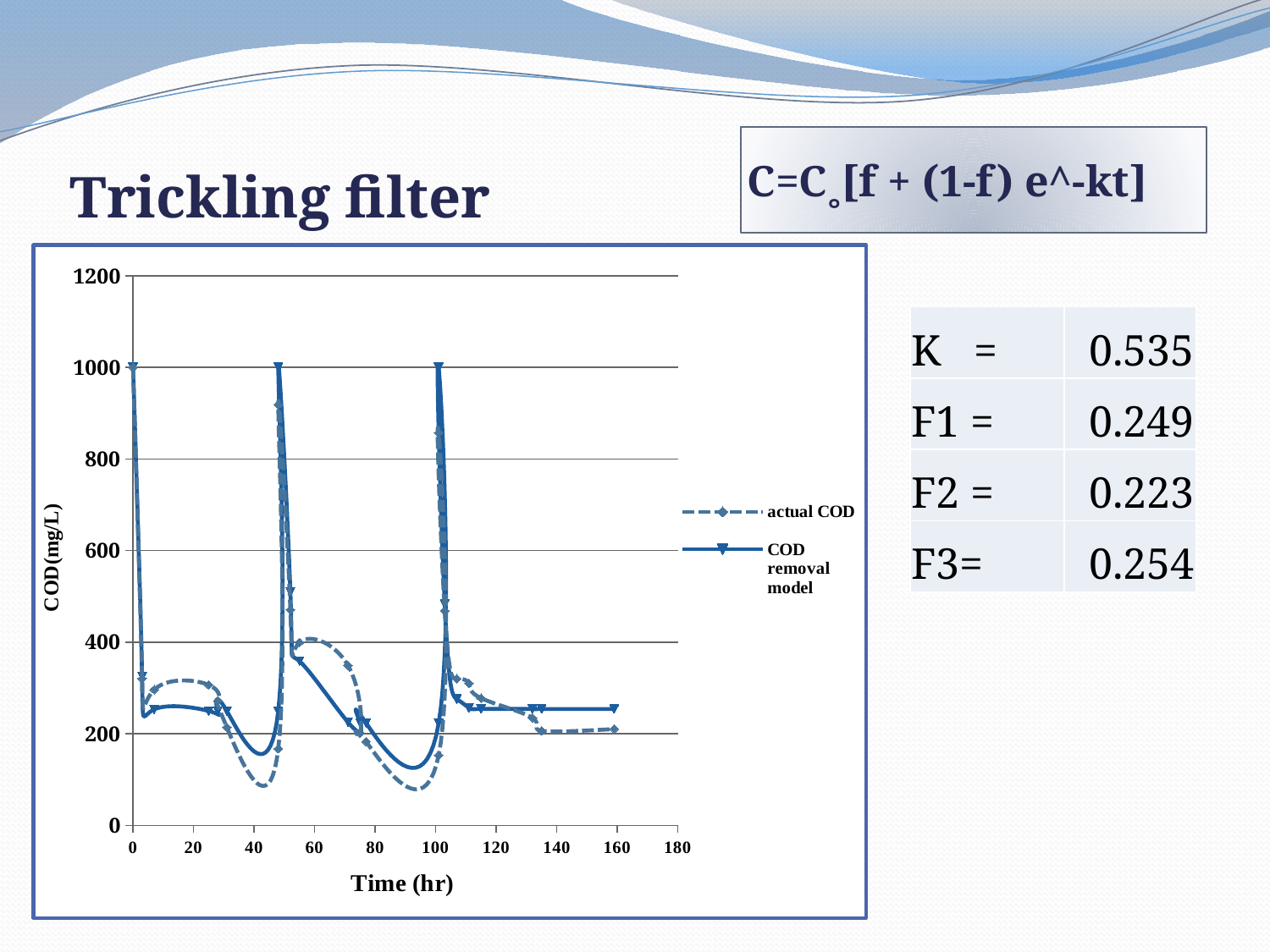
What is the title of the chart's x axis? Time (hr) At time 20, which series has the higher value, actual COD or COD removal model? actual COD Is the value of the COD removal model at time 160 greater or less than 200? greater How many series does the chart legend list? 2 Is the value of the COD removal model at time 0 greater or less than 800? greater What is the highest value shown on the chart's y axis? 1200 What kind of chart is shown on the slide? line chart At time 140, which series has the higher value, actual COD or COD removal model? COD removal model Is the value of actual COD at time 40 greater or less than 200? less What are the two series named in the chart legend? actual COD and COD removal model